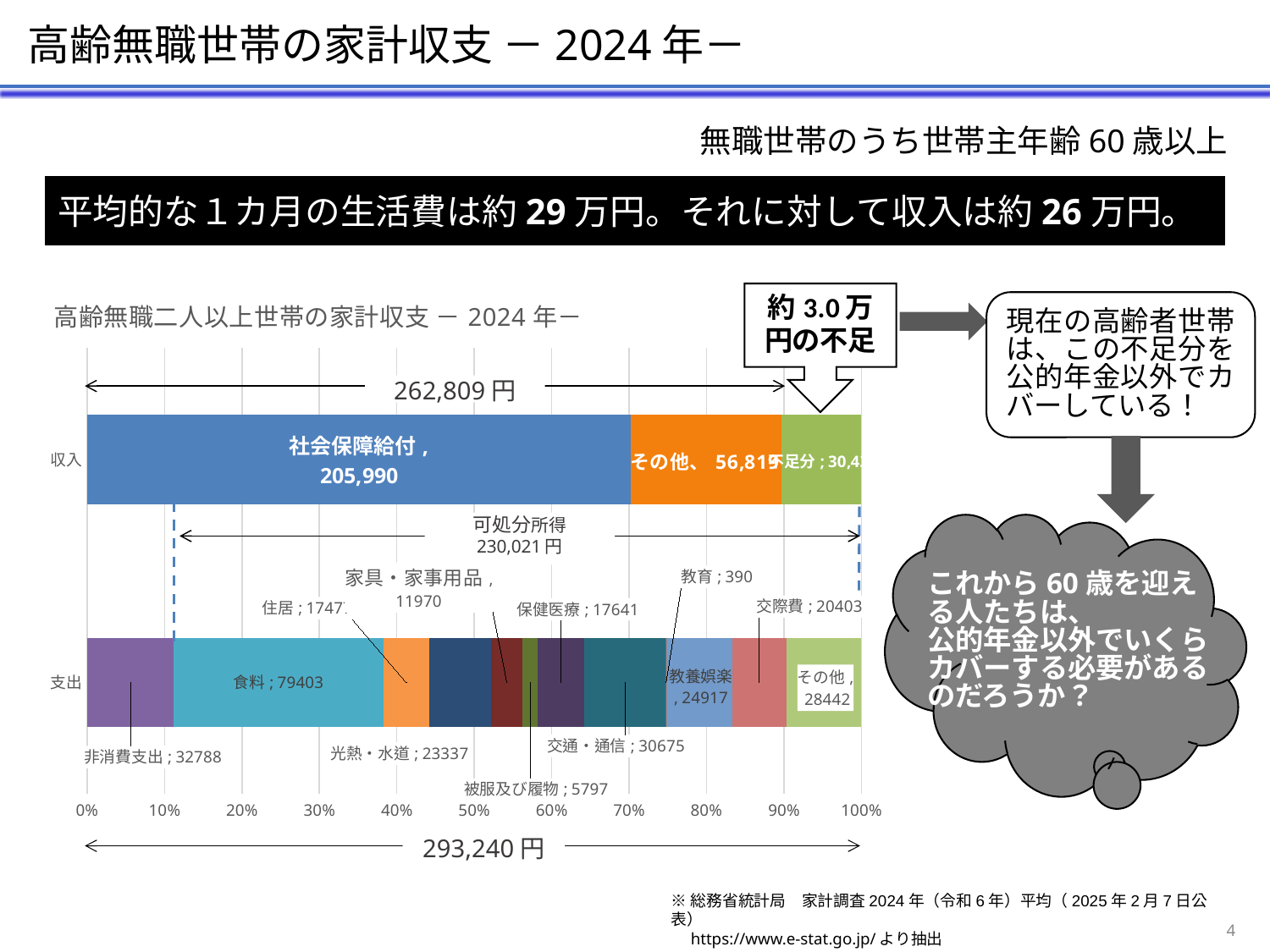
In the chart, which is larger in the 支出 bar: 交通・通信 or 教養娯楽? 交通・通信 In the chart, what total amount is shown above the 収入 bar? 262,809 円 What kind of chart is shown on the slide? Stacked bar chart In the chart, which segment of the 支出 bar has the smallest value? 教育 In the chart, what total amount is shown for the 支出 bar below the axis? 293,240 円 In the chart, which segment of the 支出 bar has the largest value? 食料 How many bars (categories) does the chart show? 2 In the chart, what is the value of その他 in the 収入 bar? 56,819 In the chart, what is the value of 社会保障給付 in the 収入 bar? 205,990 In the chart, what is the value of 可処分所得 shown between the two bars? 230,021 円 In the chart 高齢無職二人以上世帯の家計収支 － 2024 年－, what is the value labelled for 食料 in the 支出 bar? 79403 In the chart, what is the difference between 食料 (79403) and 非消費支出 (32788) in the 支出 bar? 46615